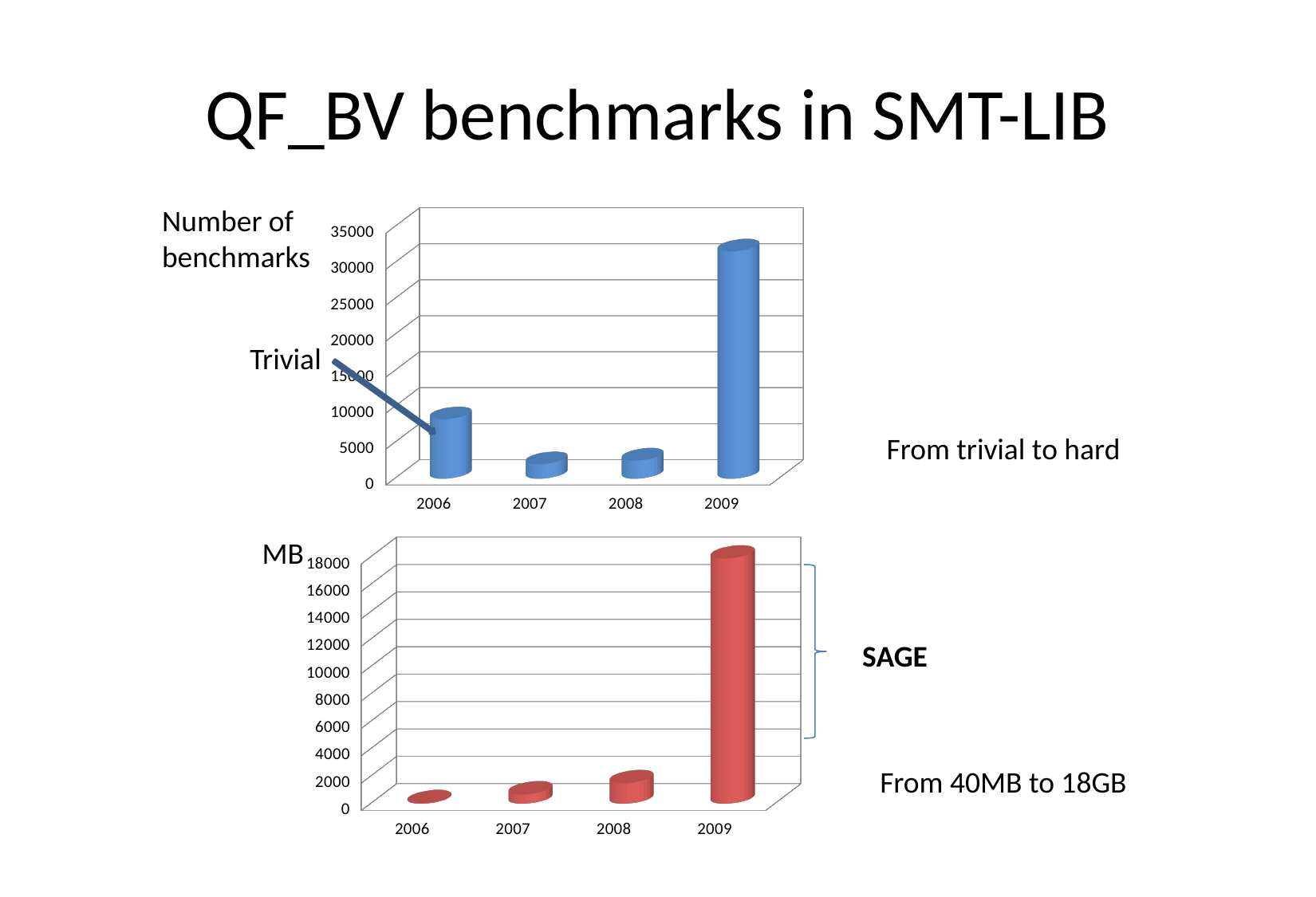
What kind of chart is the top chart (Number of benchmarks)? bar chart What colour are the bars in the bottom chart (MB)? red In the bottom chart (MB), which year has the lowest value? 2006 In the bottom chart (MB), is the value for 2009 greater or less than 16000? greater How many years are shown on the x axis of the top chart (Number of benchmarks)? 4 In the top chart (Number of benchmarks), which year has the highest number of benchmarks? 2009 In the bottom chart (MB), which year has the highest value? 2009 In the top chart (Number of benchmarks), is the value for 2009 greater or less than 25000? greater In the bottom chart (MB), do the values rise or fall from 2006 to 2009? rise In the top chart (Number of benchmarks), which is larger, the value for 2006 or the value for 2007? 2006